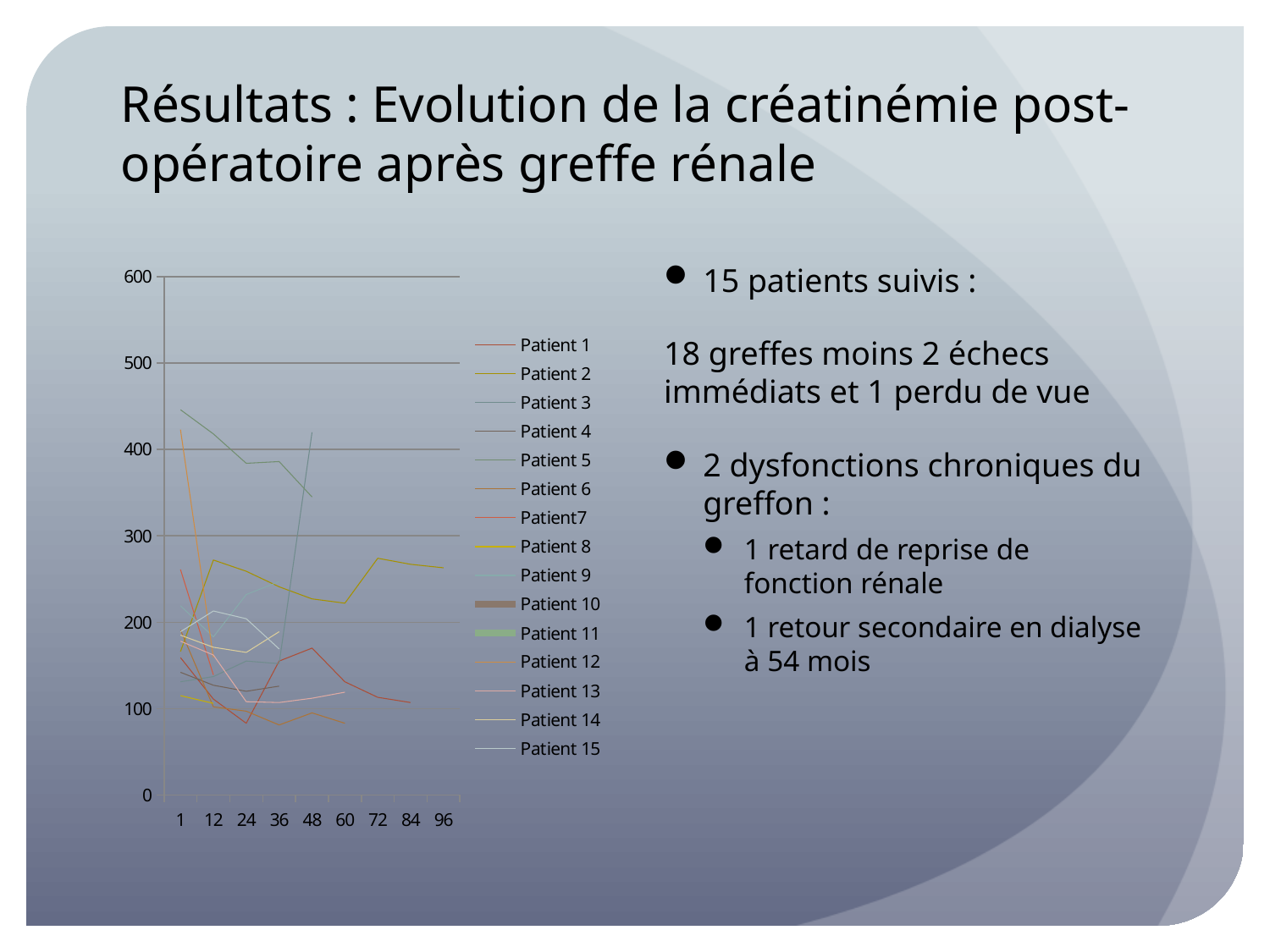
How many series does the chart's legend list? 15 How many time points are labelled on the x axis of the chart? 9 What is the highest value shown on the y axis of the chart? 600 What is the last time point labelled on the x axis of the chart? 96 Is the value for Patient 12 at time point 1 greater or less than 300? greater What kind of chart is shown on the slide? line chart